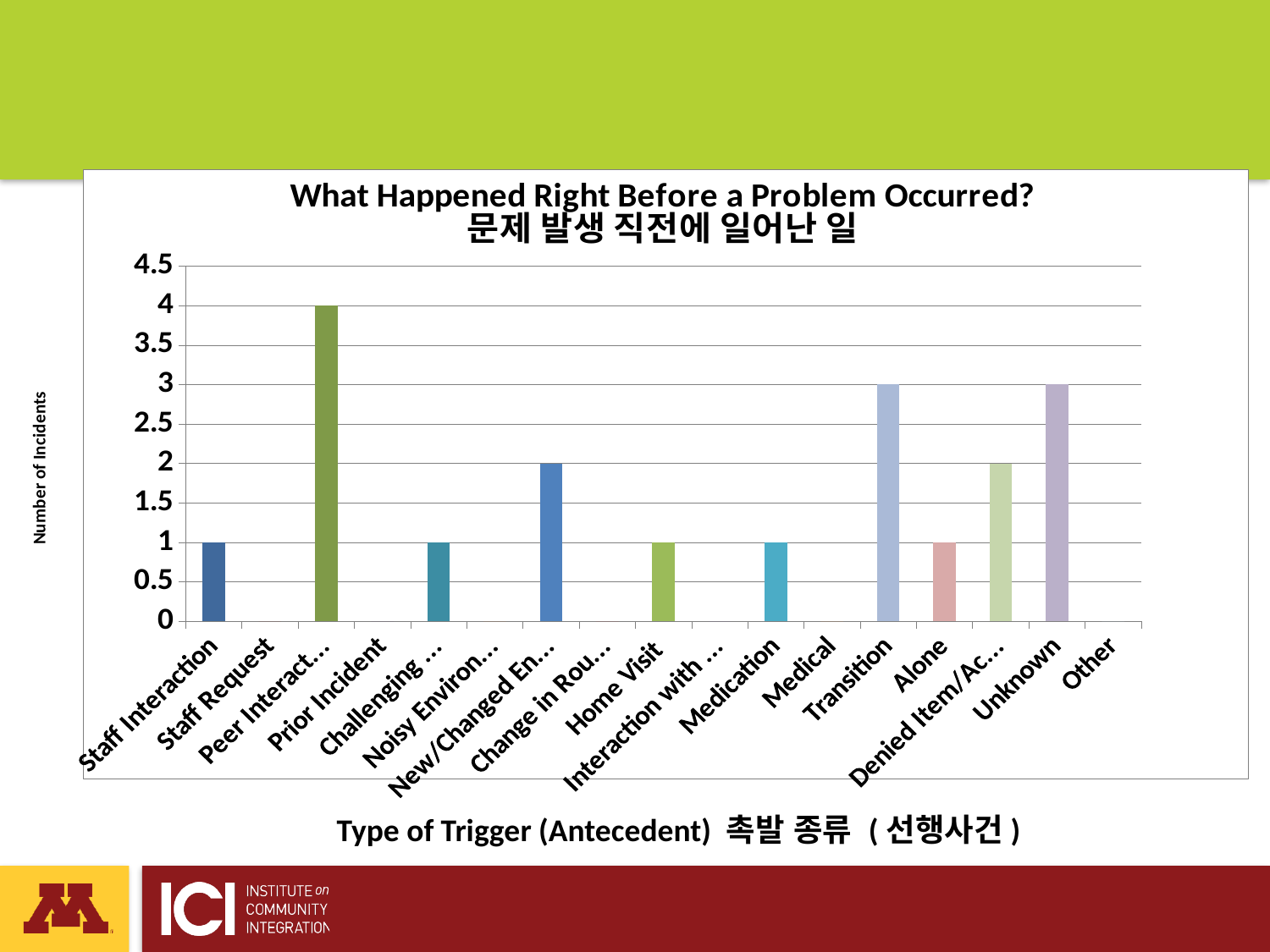
What is the number of incidents for Transition? 3 What is the number of incidents for Staff Interaction? 1 Is the value for Unknown greater or less than 2? greater What is the number of incidents for Unknown? 3 How many trigger categories are shown on the x axis? 17 What is the number of incidents for Medical? 0 What is the label of the vertical axis? Number of Incidents What is the number of incidents for Alone? 1 Which has more incidents, Transition or Home Visit? Transition What is the number of incidents for Home Visit? 1 What is the difference in number of incidents between Transition and Alone? 2 What kind of chart is shown on the slide? Bar chart